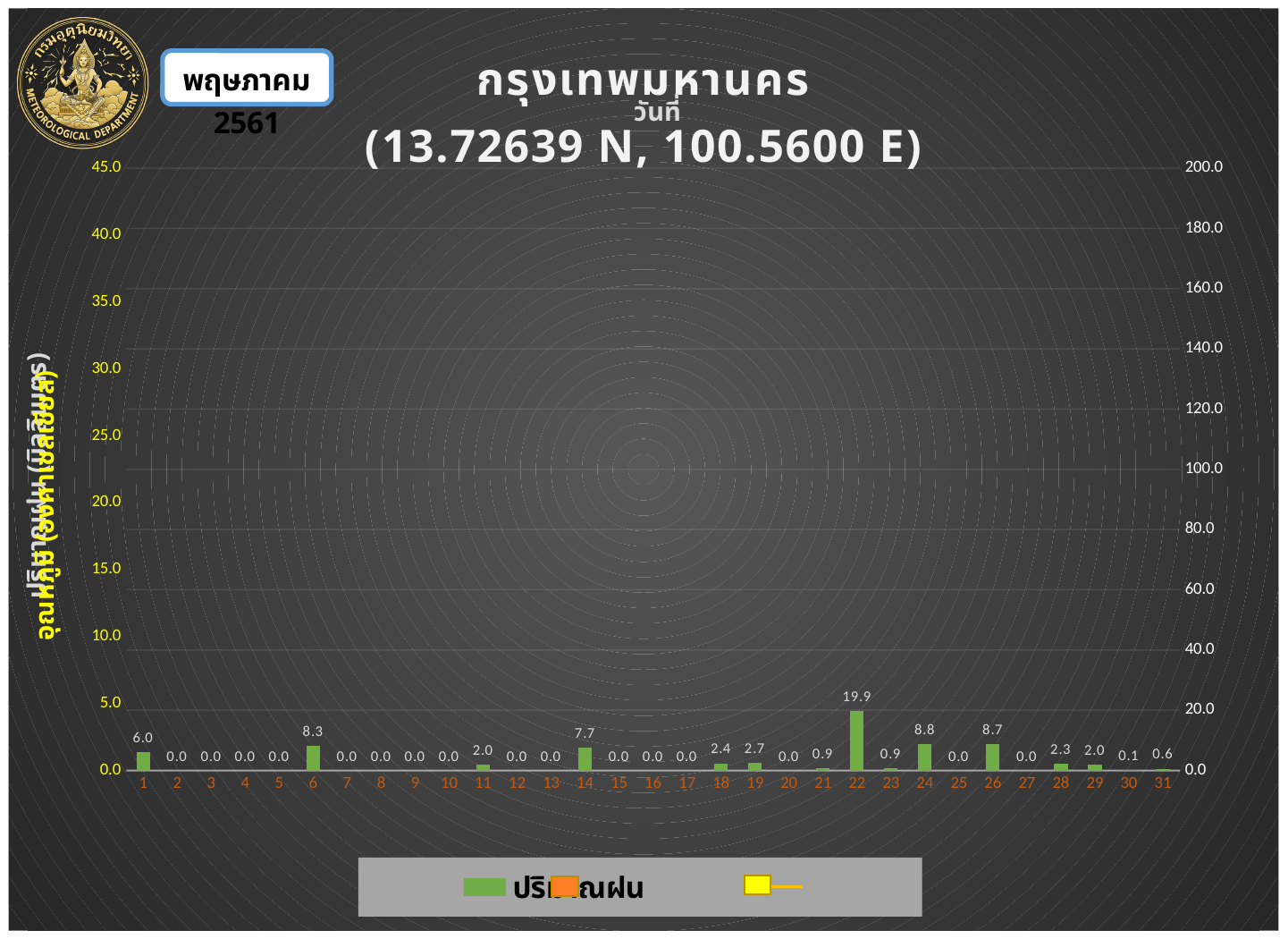
What is the value shown for day 6? 8.3 What is the value shown for day 1? 6.0 Which has the larger value, day 19 or day 18? day 19 How many days are shown on the x axis? 31 What is the value shown for day 22? 19.9 What is the value shown for day 14? 7.7 Which has the larger value, day 24 or day 26? day 24 Which day has the highest value? 22 What kind of chart is shown on the slide? bar chart What is the difference between the values for day 6 and day 1? 2.3 What is the difference between the values for day 22 and day 24? 11.1 What is the value shown for day 30? 0.1